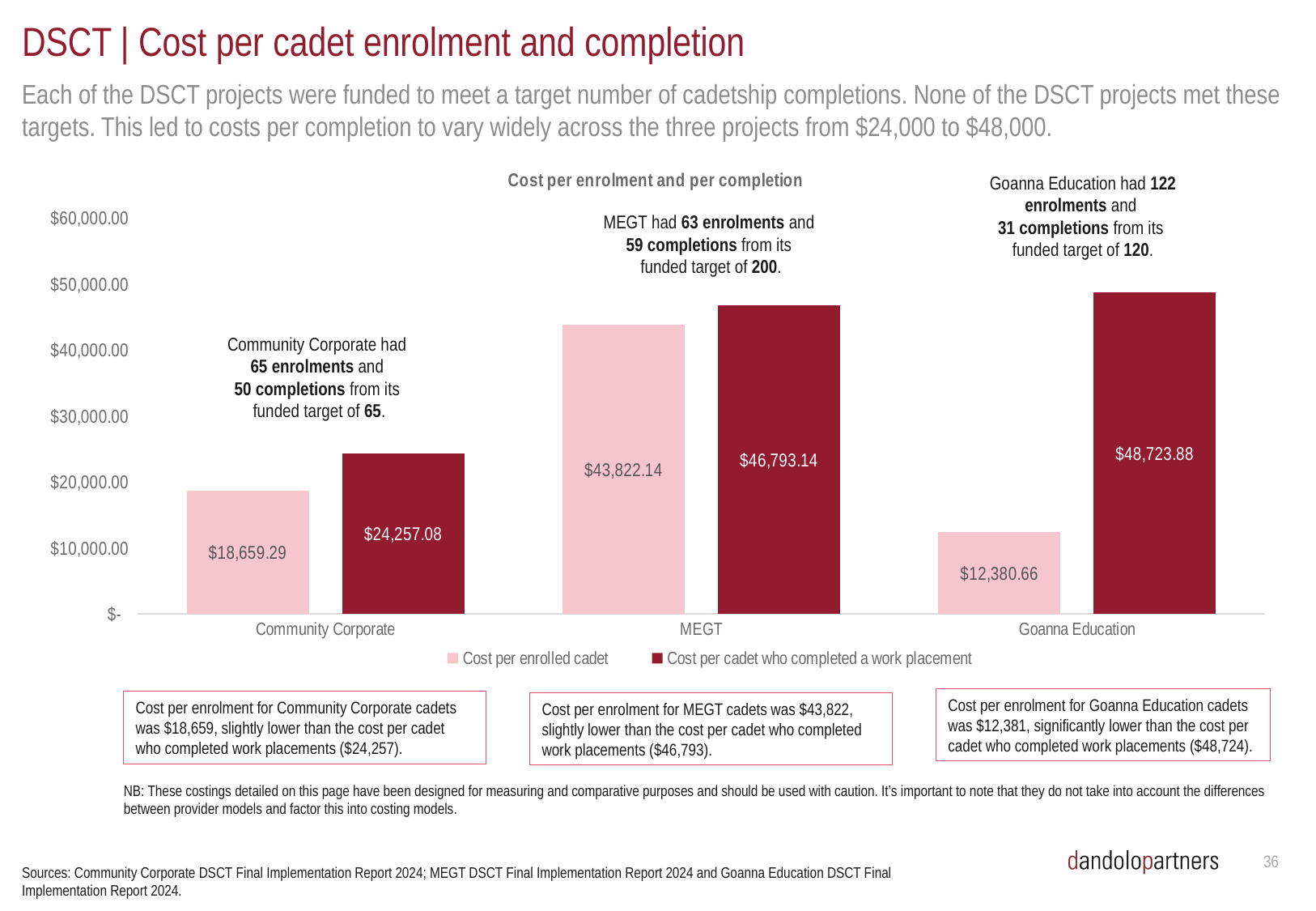
How many projects are shown on the x axis of the chart? 3 What is the difference between the cost per cadet who completed a work placement and the cost per enrolled cadet for Goanna Education? $36,343.22 Which project has the lowest cost per enrolled cadet? Goanna Education What is the cost per enrolled cadet for Community Corporate? $18,659.29 What is the difference between the cost per cadet who completed a work placement and the cost per enrolled cadet for Community Corporate? $5,597.79 Which is larger: the cost per enrolled cadet for MEGT or the cost per cadet who completed a work placement for Community Corporate? Cost per enrolled cadet for MEGT What type of chart is shown on the slide? Bar chart Is the cost per cadet who completed a work placement for MEGT greater or less than $40,000.00? greater How many series does the chart legend list? 2 Which project has the highest cost per cadet who completed a work placement? Goanna Education What is the cost per enrolled cadet for MEGT? $43,822.14 What is the cost per cadet who completed a work placement for Goanna Education? $48,723.88